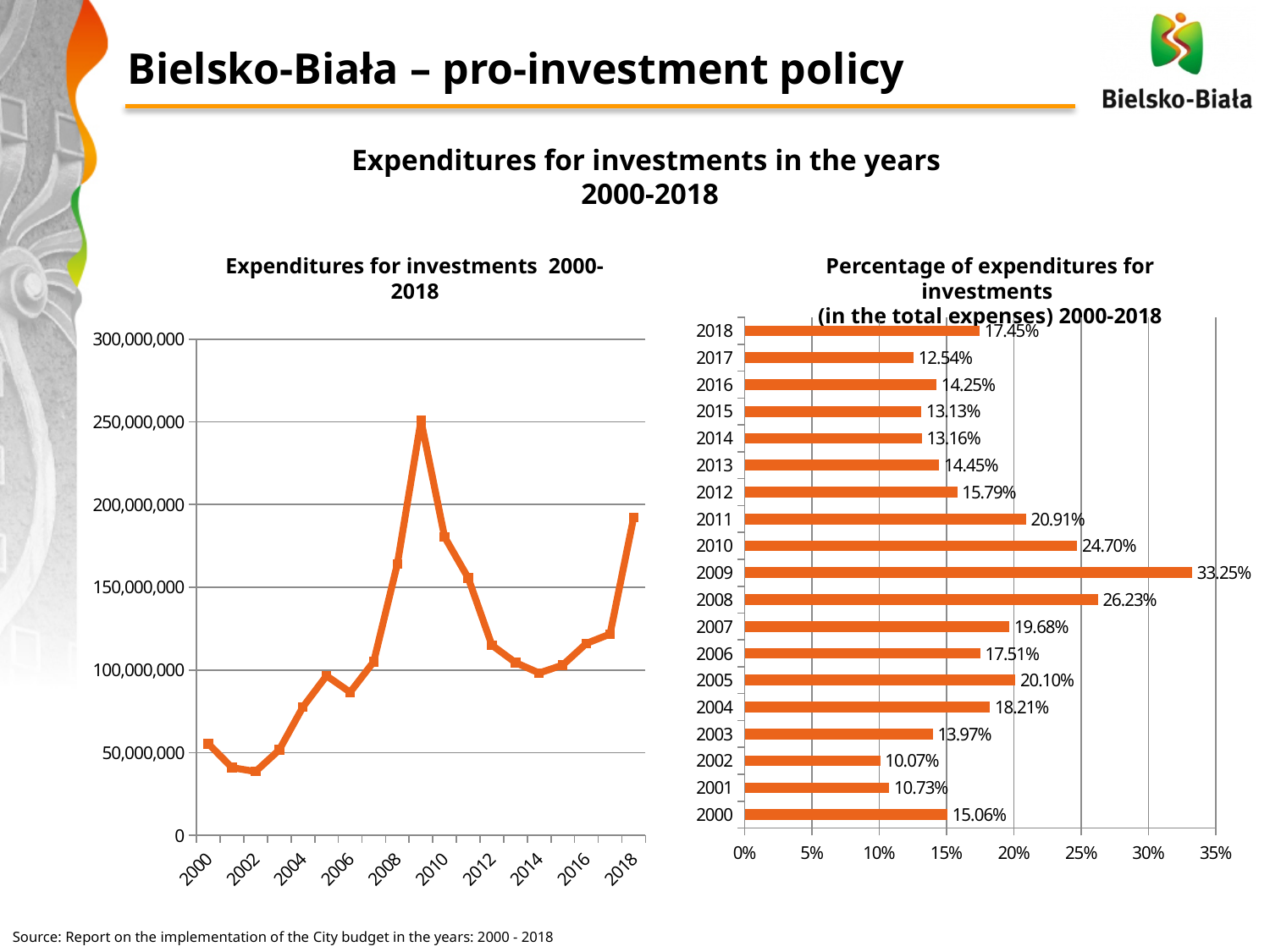
In the chart titled 'Percentage of expenditures for investments (in the total expenses) 2000-2018', how many years are shown? 19 In the chart titled 'Percentage of expenditures for investments (in the total expenses) 2000-2018', what is the value for 2018? 17.45% In the chart titled 'Percentage of expenditures for investments (in the total expenses) 2000-2018', what is the value for 2009? 33.25% In the chart titled 'Percentage of expenditures for investments (in the total expenses) 2000-2018', what is the difference between the values for 2009 and 2008? 7.02 percentage points In the chart titled 'Percentage of expenditures for investments (in the total expenses) 2000-2018', which year has the lowest value? 2002 In the chart titled 'Percentage of expenditures for investments (in the total expenses) 2000-2018', which year has the highest value? 2009 What kind of chart is the chart titled 'Expenditures for investments 2000-2018' on the left of the slide? Line chart In the chart titled 'Expenditures for investments 2000-2018', do the values rise or fall between 2009 and 2014? fall In the chart titled 'Percentage of expenditures for investments (in the total expenses) 2000-2018', what is the value for 2000? 15.06% In the chart titled 'Expenditures for investments 2000-2018', is the value for 2009 greater or less than 200,000,000? greater In the chart titled 'Percentage of expenditures for investments (in the total expenses) 2000-2018', which is larger, the value for 2010 or the value for 2011? 2010 What kind of chart is the chart on the right of the slide? Bar chart